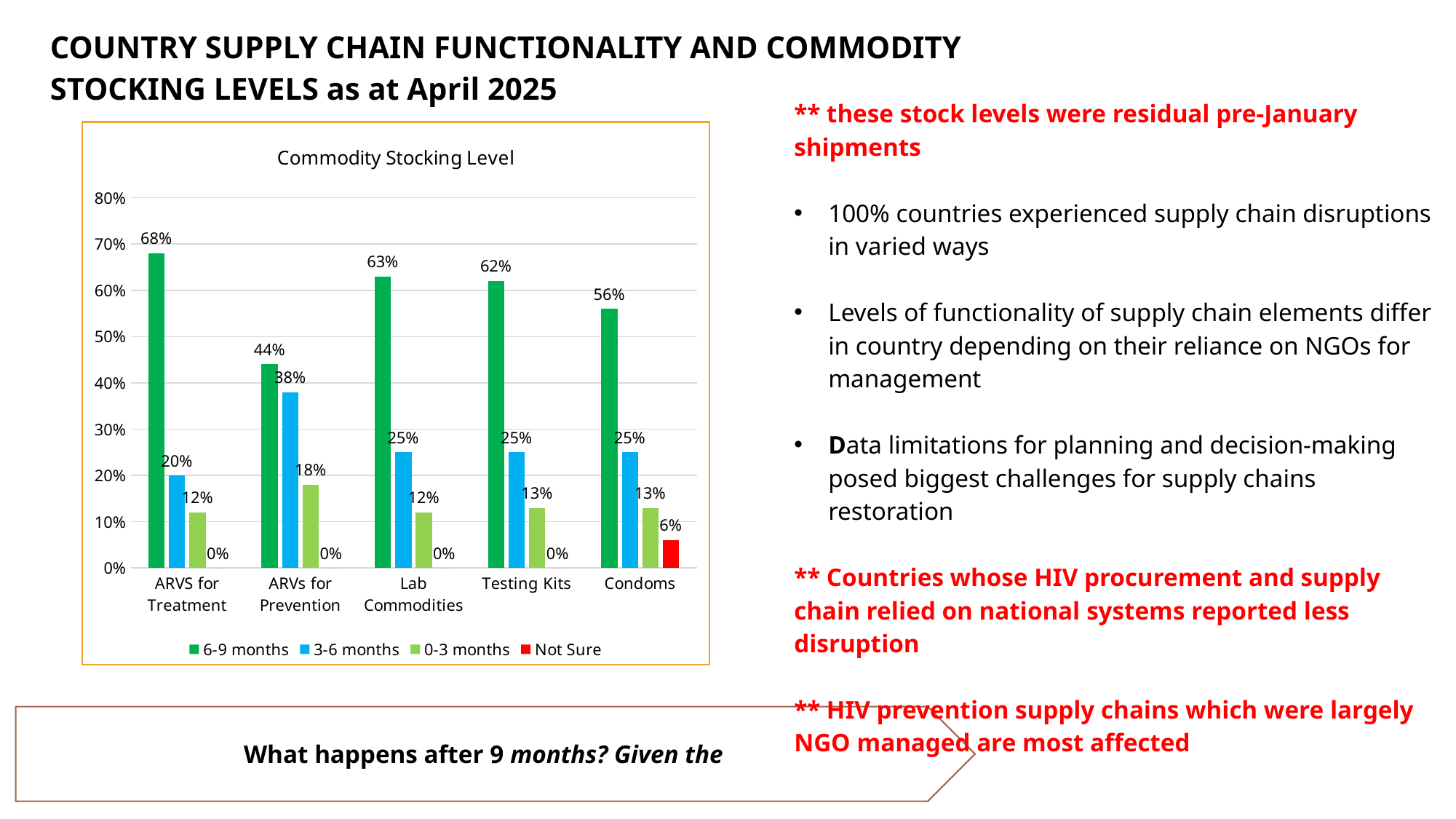
What is the value for Not Sure for Condoms? 6% What is the value for 0-3 months for Testing Kits? 13% What is the value for 3-6 months for ARVs for Prevention? 38% What is the value for 6-9 months for ARVS for Treatment? 68% How many series does the legend list? 4 Which is larger: the 3-6 months value for ARVs for Prevention or for Testing Kits? ARVs for Prevention What kind of chart is shown? Bar chart How many categories are shown on the x axis? 5 Which category has the highest value for 6-9 months? ARVS for Treatment Which category has the lowest value for 6-9 months? ARVs for Prevention What is the difference between the 6-9 months values for Lab Commodities and Condoms? 7% What is the title of the chart? Commodity Stocking Level